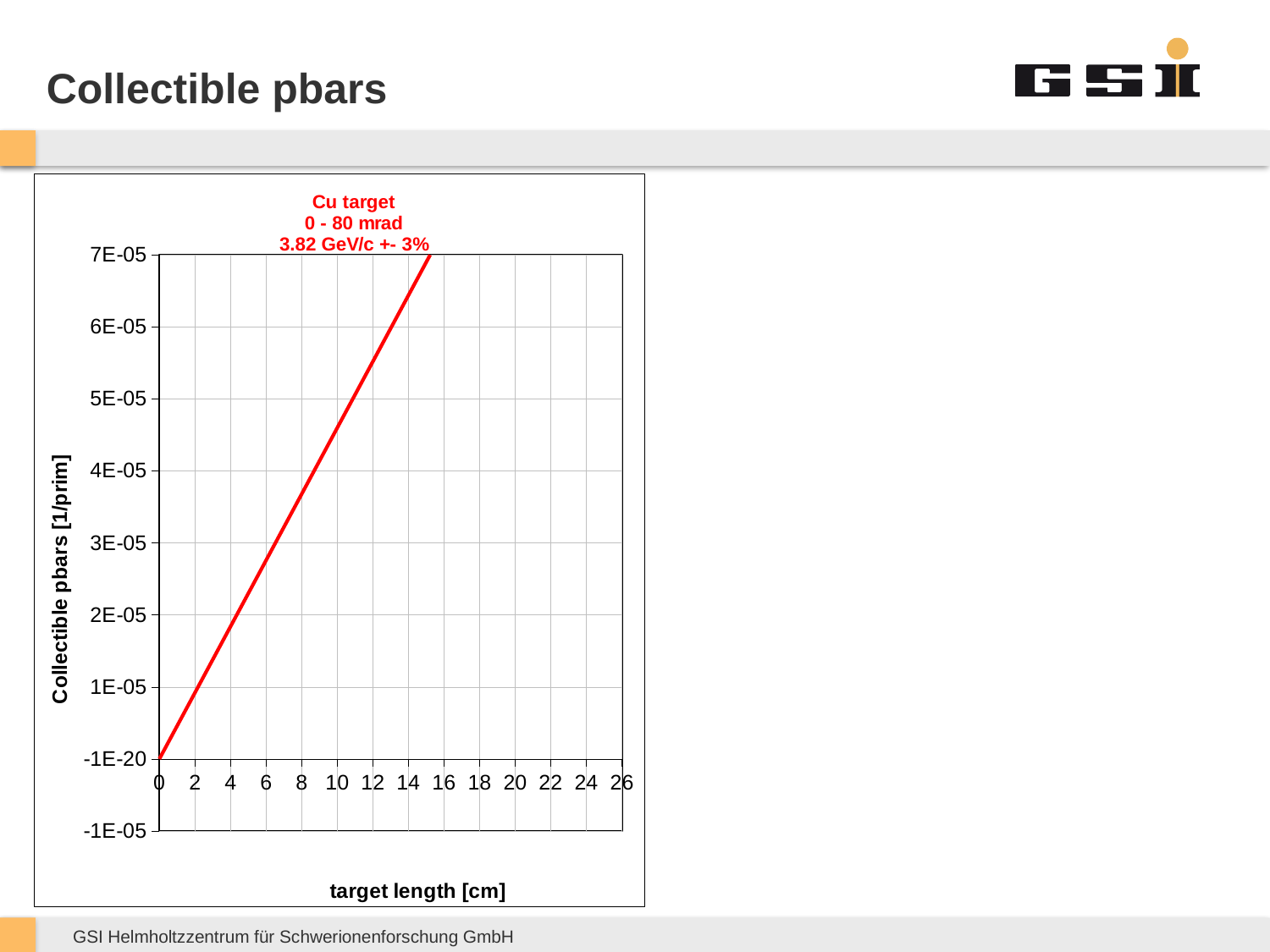
Is the collectible pbars value at a target length of 6 cm greater or less than 3E-05? less What is the title printed above the chart? Cu target 0 - 80 mrad 3.82 GeV/c +- 3% What kind of chart is shown on the slide? line chart Is the collectible pbars value at a target length of 14 cm greater or less than 6E-05? greater What is the highest tick value shown on the y axis of the chart? 7E-05 What is the x-axis title of the chart? target length [cm] Does the collectible pbars value rise or fall as target length increases? rise Is the collectible pbars value at a target length of 12 cm greater or less than 5E-05? greater How many lines are plotted on the chart? 1 What is the highest tick value shown on the x axis of the chart? 26